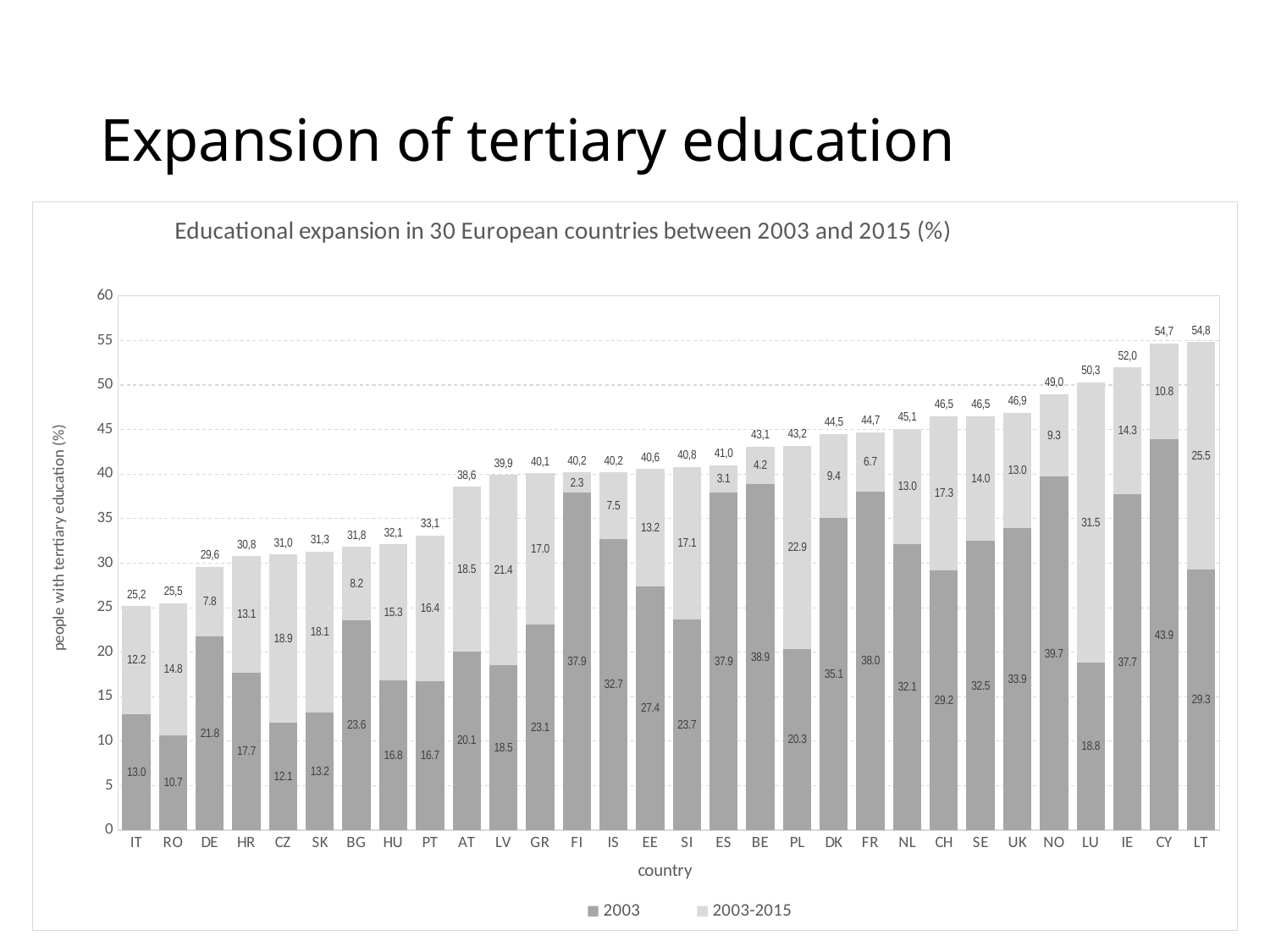
Is the total value for PL greater or less than 40? greater What kind of chart is shown on the slide? stacked bar chart What is the 2003-2015 value for LT? 25.5 Do the total bar heights rise or fall from left to right along the x axis? rise What is the 2003 value for IT? 13.0 Which country has the lowest 2003 value? RO Which country has the highest 2003 value? CY What is the total value shown above the bar for CY? 54,7 How many countries are shown on the x axis? 30 How many series does the legend list? 2 Which is larger, the 2003 value for NO or the 2003 value for LU? NO What is the difference between the 2003 values for CY and RO? 33.2